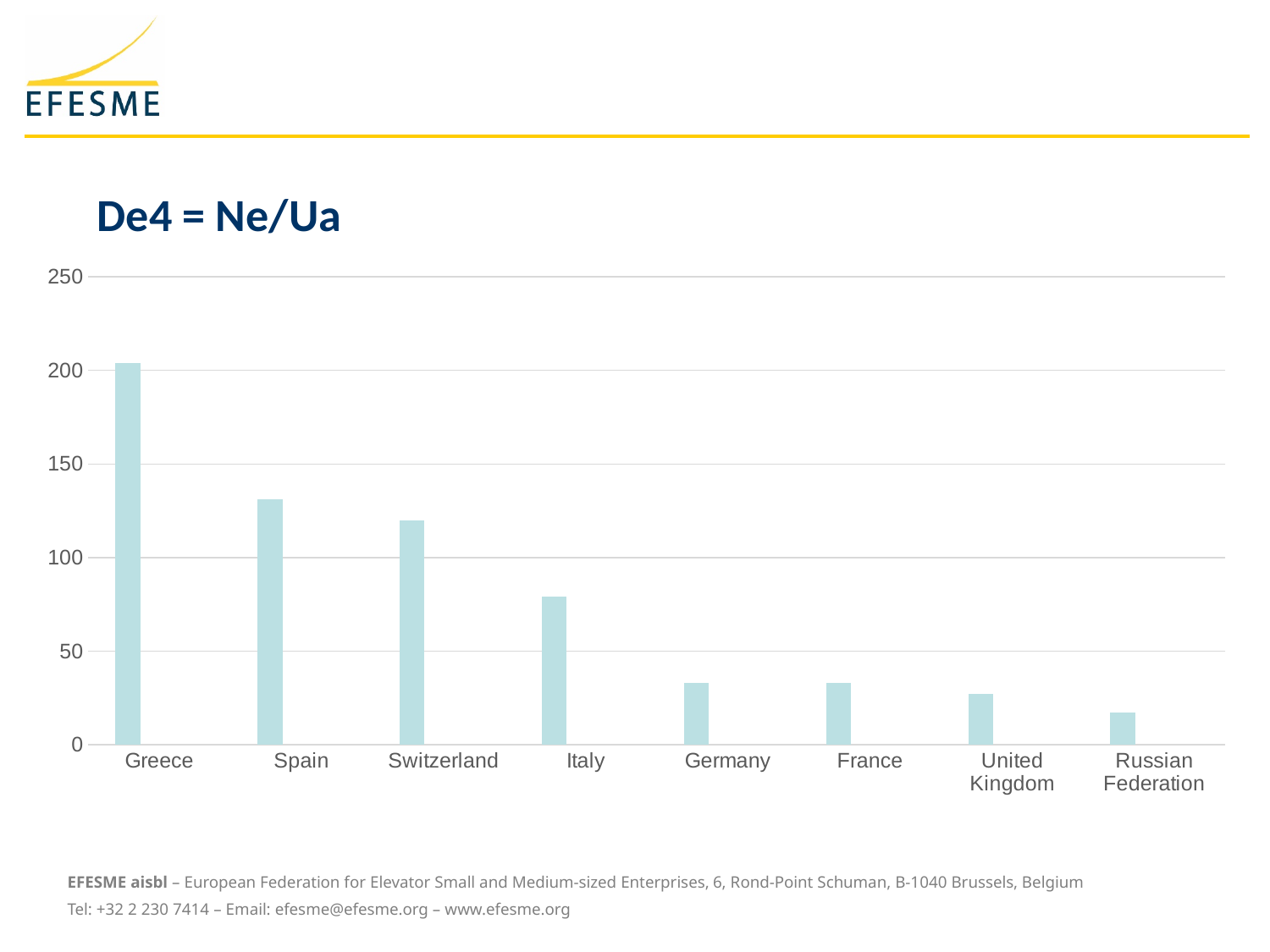
Is the value for Italy greater or less than 100? less Which is larger, the value for Spain or the value for Italy? Spain Is the value for Switzerland greater or less than 100? greater Is the value for Greece greater or less than 200? greater How many countries are shown on the x axis of the chart? 8 Which country has the lowest value in the chart? Russian Federation What is the title of the chart? De4 = Ne/Ua Do the values generally rise or fall from left to right along the x axis? fall Which country has the highest value in the chart? Greece What kind of chart is shown on the slide? bar chart